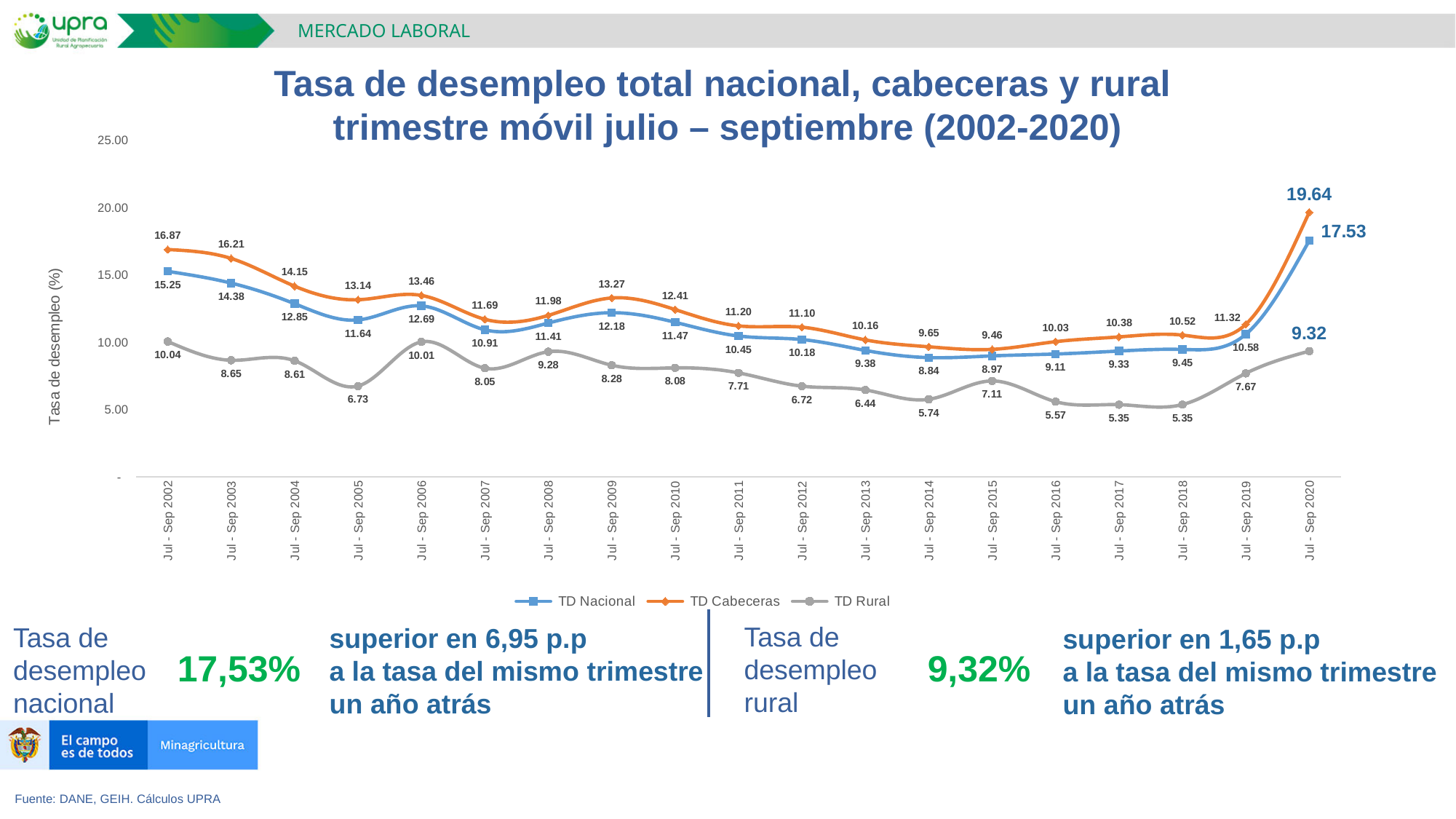
Is the value for TD Cabeceras in Jul - Sep 2020 greater or less than 15.00? greater How many series does the legend list? 3 What is the value of TD Cabeceras for Jul - Sep 2020? 19.64 What is the value of TD Nacional for Jul - Sep 2014? 8.84 How many periods are plotted on the x axis? 19 What is the value of TD Rural for Jul - Sep 2005? 6.73 In which period does TD Nacional reach its highest value? Jul - Sep 2020 What is the difference between TD Rural in Jul - Sep 2020 and Jul - Sep 2019? 1.65 In which period does TD Cabeceras reach its lowest value? Jul - Sep 2015 What is the difference between TD Nacional in Jul - Sep 2020 and Jul - Sep 2019? 6.95 Which is larger for TD Cabeceras: Jul - Sep 2009 or Jul - Sep 2010? Jul - Sep 2009 What kind of chart is shown on the slide? line chart